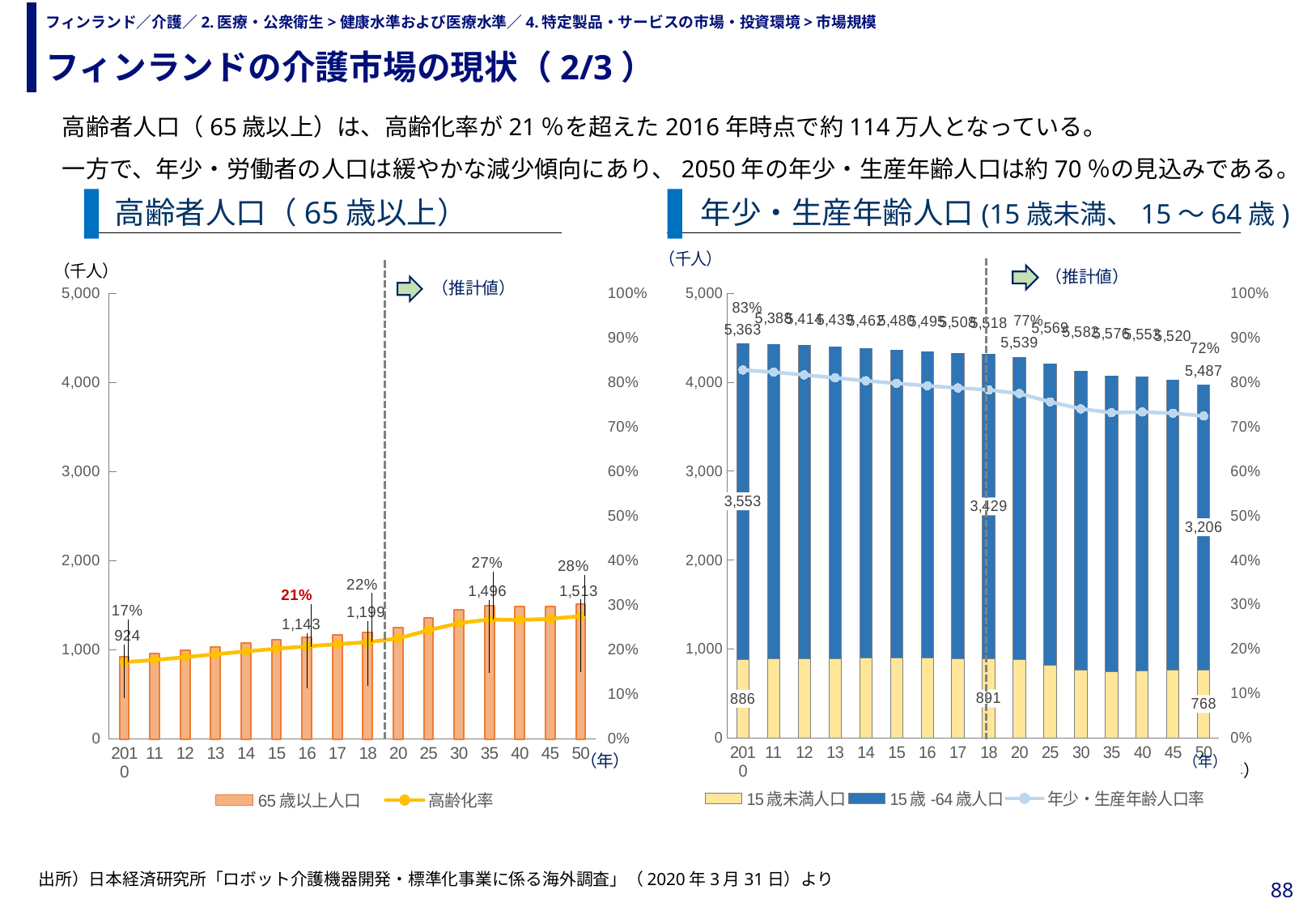
In the 年少・生産年齢人口 chart on the right, what is the 15歳未満人口 value for 2050? 768 In the 高齢者人口（65歳以上） chart, what is the difference between the 65歳以上人口 values for 2050 and 2010? 589 In the 高齢者人口（65歳以上） chart, what is the 65歳以上人口 value for 2010? 924 In the 年少・生産年齢人口 chart on the right, what is the 15歳-64歳人口 value for 2018? 3,429 In the 高齢者人口（65歳以上） chart, do the 65歳以上人口 bars rise or fall from 2010 to 2050? rise How many series does the legend of the 年少・生産年齢人口 chart on the right list? 3 In the 高齢者人口（65歳以上） chart, what is the 高齢化率 for 2016? 21% How many years are shown on the x axis of the 高齢者人口（65歳以上） chart? 16 What kind of chart is the 高齢者人口（65歳以上） chart on the left? bar chart with a line In the 高齢者人口（65歳以上） chart, is the 65歳以上人口 value for 2030 greater or less than 1,000? greater In the 高齢者人口（65歳以上） chart, what is the 65歳以上人口 value for 2050? 1,513 In the 年少・生産年齢人口 chart on the right, what is the difference between the 15歳-64歳人口 values for 2010 and 2050? 347